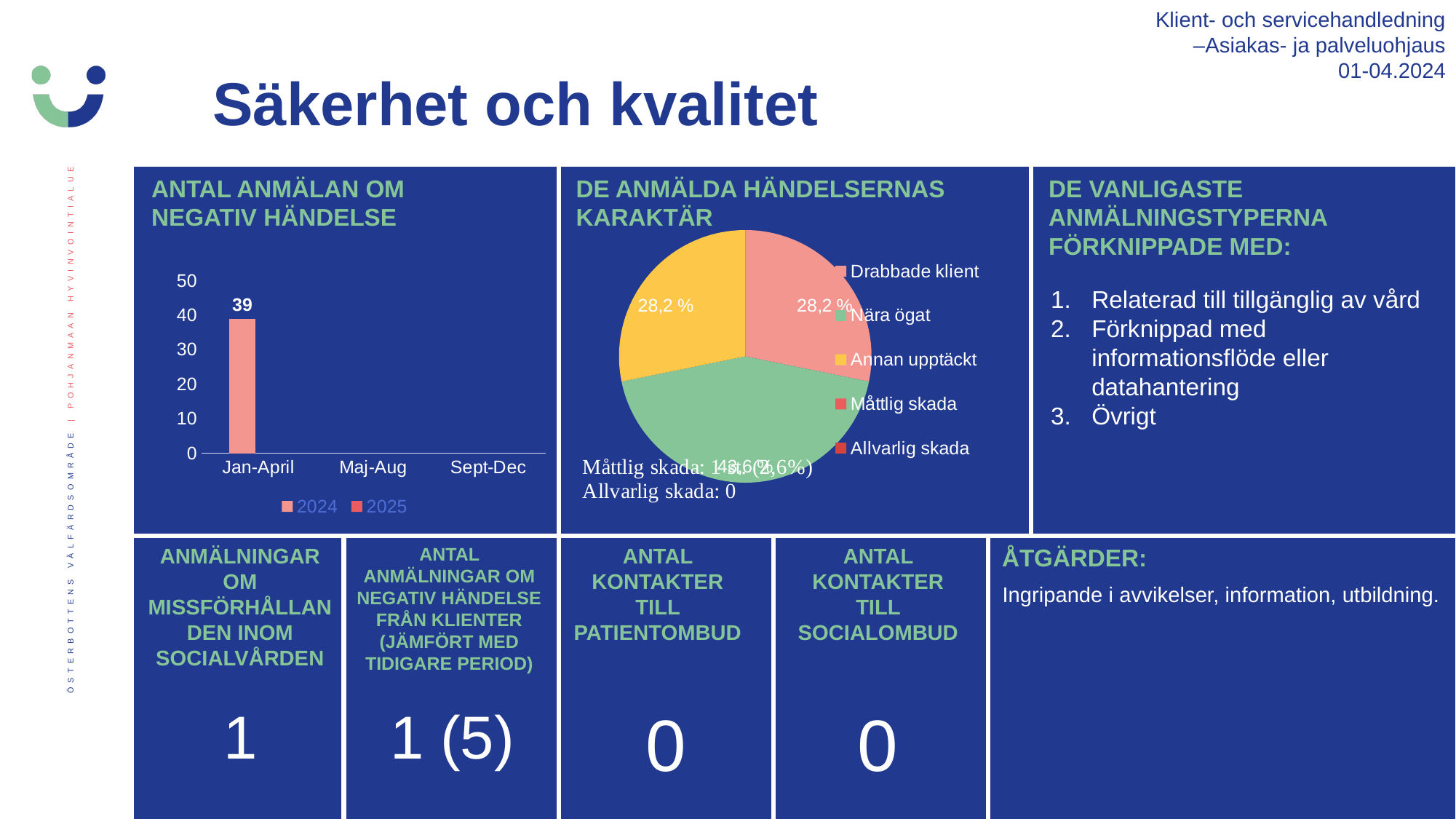
How many categories are shown on the x axis of the chart "ANTAL ANMÄLAN OM NEGATIV HÄNDELSE"? 3 How many series does the legend of the chart "ANTAL ANMÄLAN OM NEGATIV HÄNDELSE" list? 2 In the pie chart "DE ANMÄLDA HÄNDELSERNAS KARAKTÄR", what share does Annan upptäckt have? 28,2 % What kind of chart is "ANTAL ANMÄLAN OM NEGATIV HÄNDELSE"? Bar chart What kind of chart is "DE ANMÄLDA HÄNDELSERNAS KARAKTÄR"? Pie chart In the pie chart "DE ANMÄLDA HÄNDELSERNAS KARAKTÄR", which category has the largest slice? Nära ögat In the chart "ANTAL ANMÄLAN OM NEGATIV HÄNDELSE", what is the value for Jan-April? 39 In the chart "ANTAL ANMÄLAN OM NEGATIV HÄNDELSE", is the value for Jan-April greater or less than 30? greater What is the highest value shown on the y axis of the chart "ANTAL ANMÄLAN OM NEGATIV HÄNDELSE"? 50 How many entries does the legend of the pie chart "DE ANMÄLDA HÄNDELSERNAS KARAKTÄR" list? 5 In the pie chart "DE ANMÄLDA HÄNDELSERNAS KARAKTÄR", what share does Drabbade klient have? 28,2 % Which series are listed in the legend of the chart "ANTAL ANMÄLAN OM NEGATIV HÄNDELSE"? 2024 and 2025